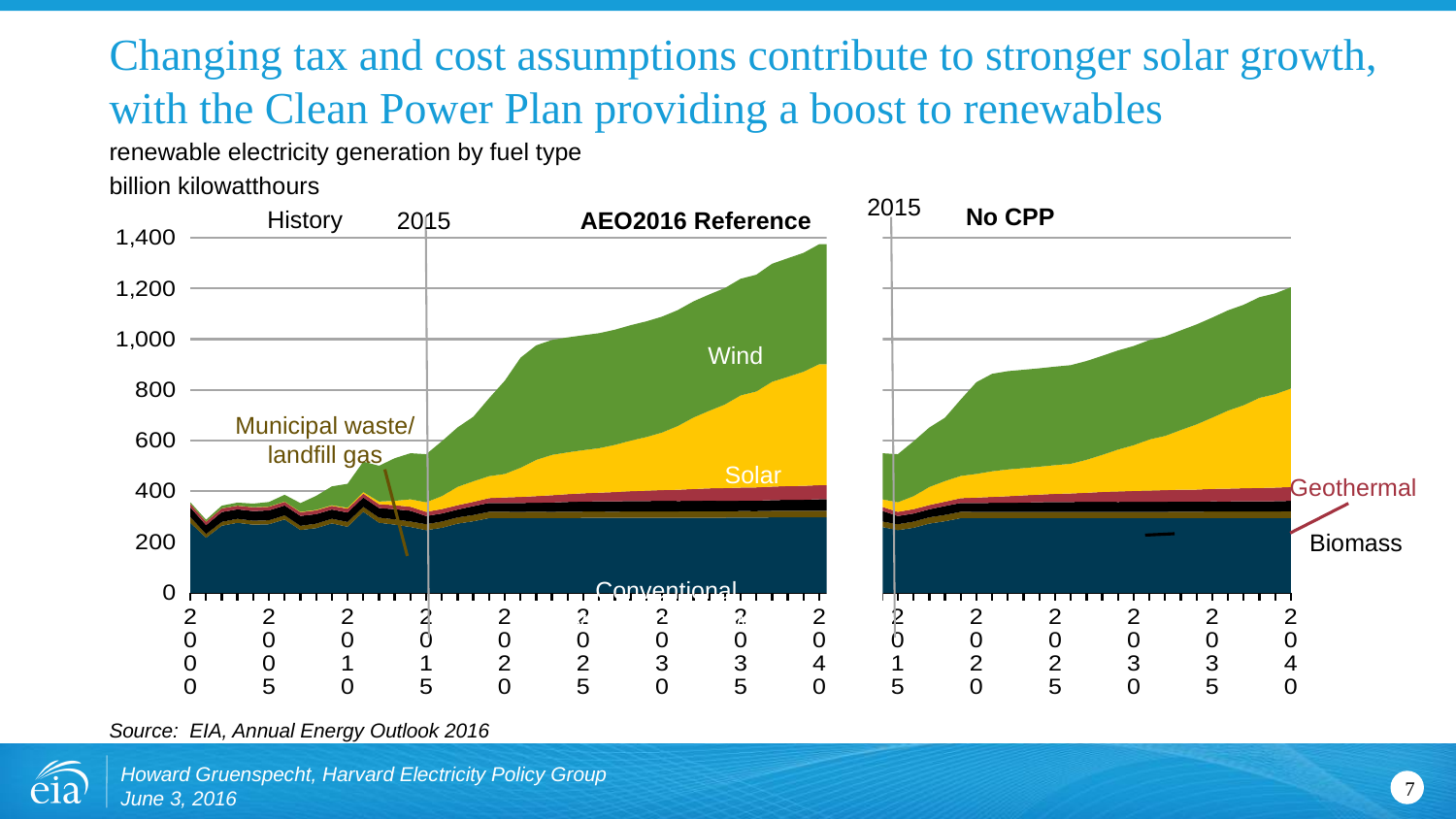
In the AEO2016 Reference chart, which fuel type forms the top (largest-growing) layer of the stack in 2040? Wind What is the title of the right-hand chart? No CPP What kind of chart is used on this slide to show renewable electricity generation by fuel type? stacked area chart In the AEO2016 Reference chart, is the total renewable generation in 2040 greater or less than 1,200 billion kilowatthours? greater In the AEO2016 Reference chart, does total renewable generation rise or fall between 2015 and 2040? rise Which chart shows the larger total renewable generation in 2040, AEO2016 Reference or No CPP? AEO2016 Reference In the No CPP chart, is the total renewable generation in 2040 greater or less than 1,000 billion kilowatthours? greater In the AEO2016 Reference chart, is the total renewable generation in 2000 greater or less than 600 billion kilowatthours? less What unit is used on the vertical axis of the charts? billion kilowatthours In the No CPP chart, does total renewable generation rise or fall between 2015 and 2040? rise How many fuel types are labeled across the stacked areas on the slide? 6